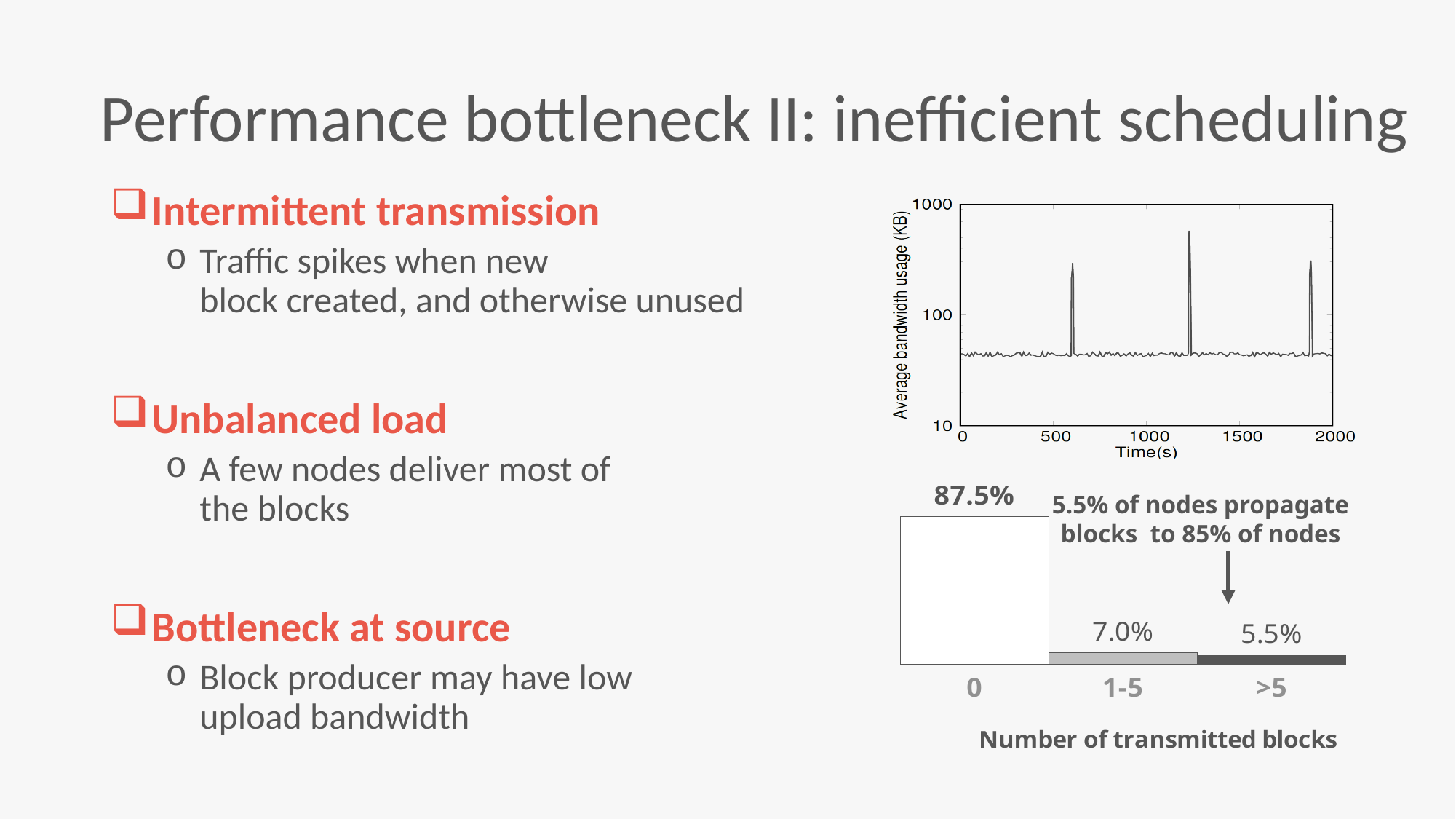
What kind of chart is the top chart? line chart In the bottom chart, what is the difference between the percentage for 0 blocks and the percentage for 1-5 blocks? 80.5% What is the x-axis label of the top chart? Time(s) In the top chart, is the baseline average bandwidth usage between the spikes greater or less than 100 KB? less In the bottom chart, what percentage of nodes transmitted 0 blocks? 87.5% In the bottom chart, which category of number of transmitted blocks has the highest percentage? 0 In the bottom chart, which is larger: the percentage for 1-5 blocks or for >5 blocks? 1-5 In the bottom chart, what percentage of nodes transmitted more than 5 blocks? 5.5% In the bottom chart, what percentage of nodes transmitted 1-5 blocks? 7.0% In the bottom chart, which category of number of transmitted blocks has the lowest percentage? >5 How many categories are shown on the x axis of the bottom chart? 3 What kind of chart is the bottom chart? bar chart